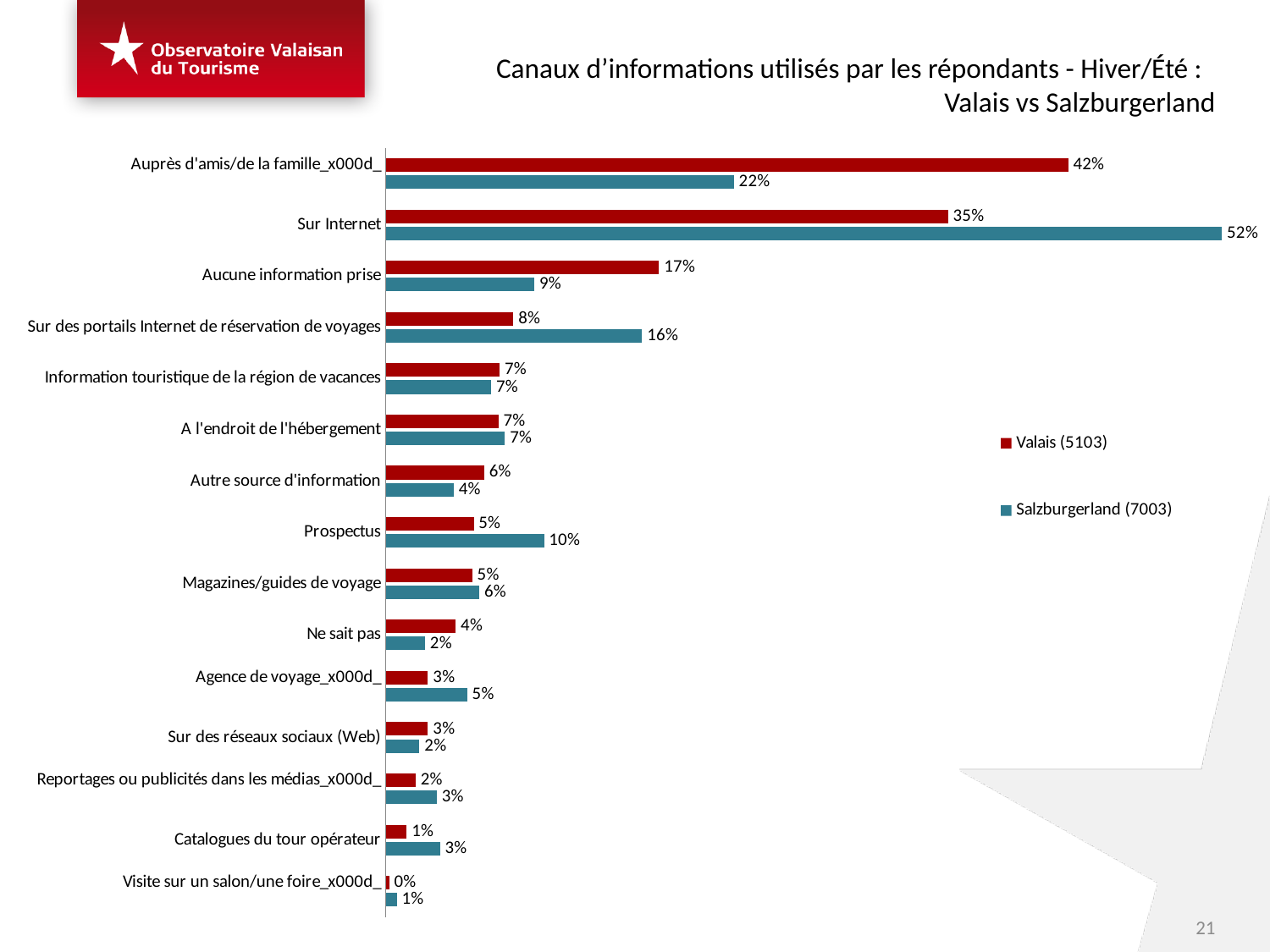
What is the Salzburgerland (7003) value for "Sur Internet"? 52% Which category has the highest Salzburgerland (7003) value? Sur Internet Which category has the highest Valais (5103) value? Auprès d'amis/de la famille What kind of chart is shown on the slide? Bar chart How many categories are shown on the chart? 15 For "Sur des portails Internet de réservation de voyages", which series has the larger value, Valais (5103) or Salzburgerland (7003)? Salzburgerland (7003) What is the difference between the Valais (5103) and Salzburgerland (7003) values for "Sur Internet"? 17% What is the difference between the Valais (5103) and Salzburgerland (7003) values for "Aucune information prise"? 8% What is the Valais (5103) value for "Auprès d'amis/de la famille"? 42% How many series does the legend list? 2 What is the Salzburgerland (7003) value for "Prospectus"? 10% Which category has the lowest Valais (5103) value? Visite sur un salon/une foire